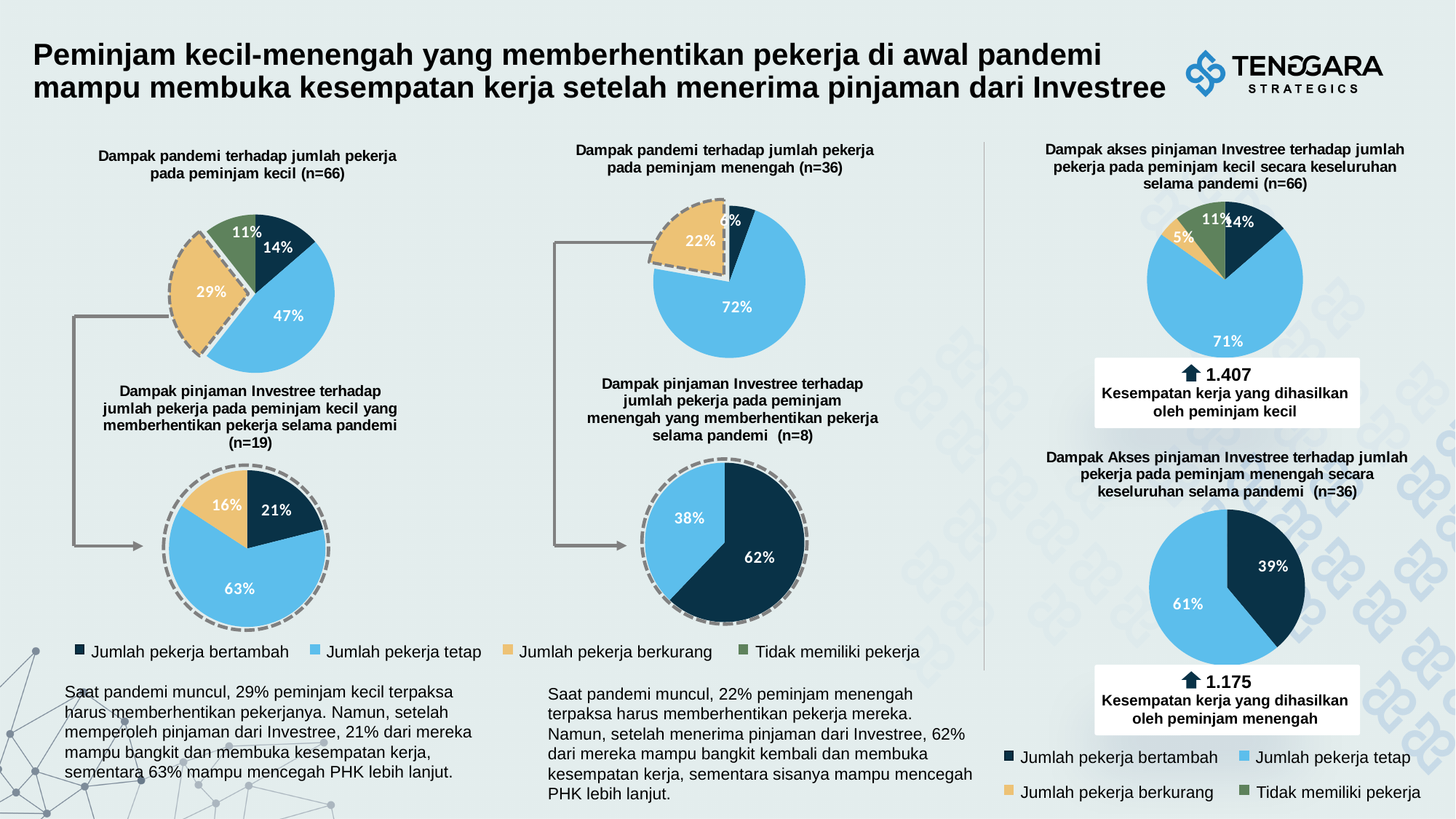
In the chart 'Dampak akses pinjaman Investree terhadap jumlah pekerja pada peminjam kecil secara keseluruhan selama pandemi (n=66)', what share is 'Jumlah pekerja berkurang'? 5% In the chart 'Dampak pinjaman Investree terhadap jumlah pekerja pada peminjam menengah yang memberhentikan pekerja selama pandemi (n=8)', how many slices does the pie have? 2 In the chart 'Dampak pinjaman Investree terhadap jumlah pekerja pada peminjam menengah yang memberhentikan pekerja selama pandemi (n=8)', which is larger, 'Jumlah pekerja bertambah' or 'Jumlah pekerja tetap'? Jumlah pekerja bertambah What type of chart is used throughout this slide? Pie chart In the chart 'Dampak pandemi terhadap jumlah pekerja pada peminjam menengah (n=36)', which category has the smallest slice? Jumlah pekerja bertambah In the chart 'Dampak Akses pinjaman Investree terhadap jumlah pekerja pada peminjam menengah secara keseluruhan selama pandemi (n=36)', what share is 'Jumlah pekerja tetap'? 61% In the chart 'Dampak pinjaman Investree terhadap jumlah pekerja pada peminjam kecil yang memberhentikan pekerja selama pandemi (n=19)', what is the difference between 'Jumlah pekerja tetap' and 'Jumlah pekerja berkurang'? 47% In the chart 'Dampak pandemi terhadap jumlah pekerja pada peminjam kecil (n=66)', what share is 'Jumlah pekerja berkurang'? 29% In the chart 'Dampak pandemi terhadap jumlah pekerja pada peminjam menengah (n=36)', what share is 'Jumlah pekerja tetap'? 72% In the chart 'Dampak pandemi terhadap jumlah pekerja pada peminjam kecil (n=66)', which category has the largest slice? Jumlah pekerja tetap How many categories does the legend at the bottom left of the slide list? 4 In the chart 'Dampak pinjaman Investree terhadap jumlah pekerja pada peminjam kecil yang memberhentikan pekerja selama pandemi (n=19)', what share is 'Jumlah pekerja bertambah'? 21%